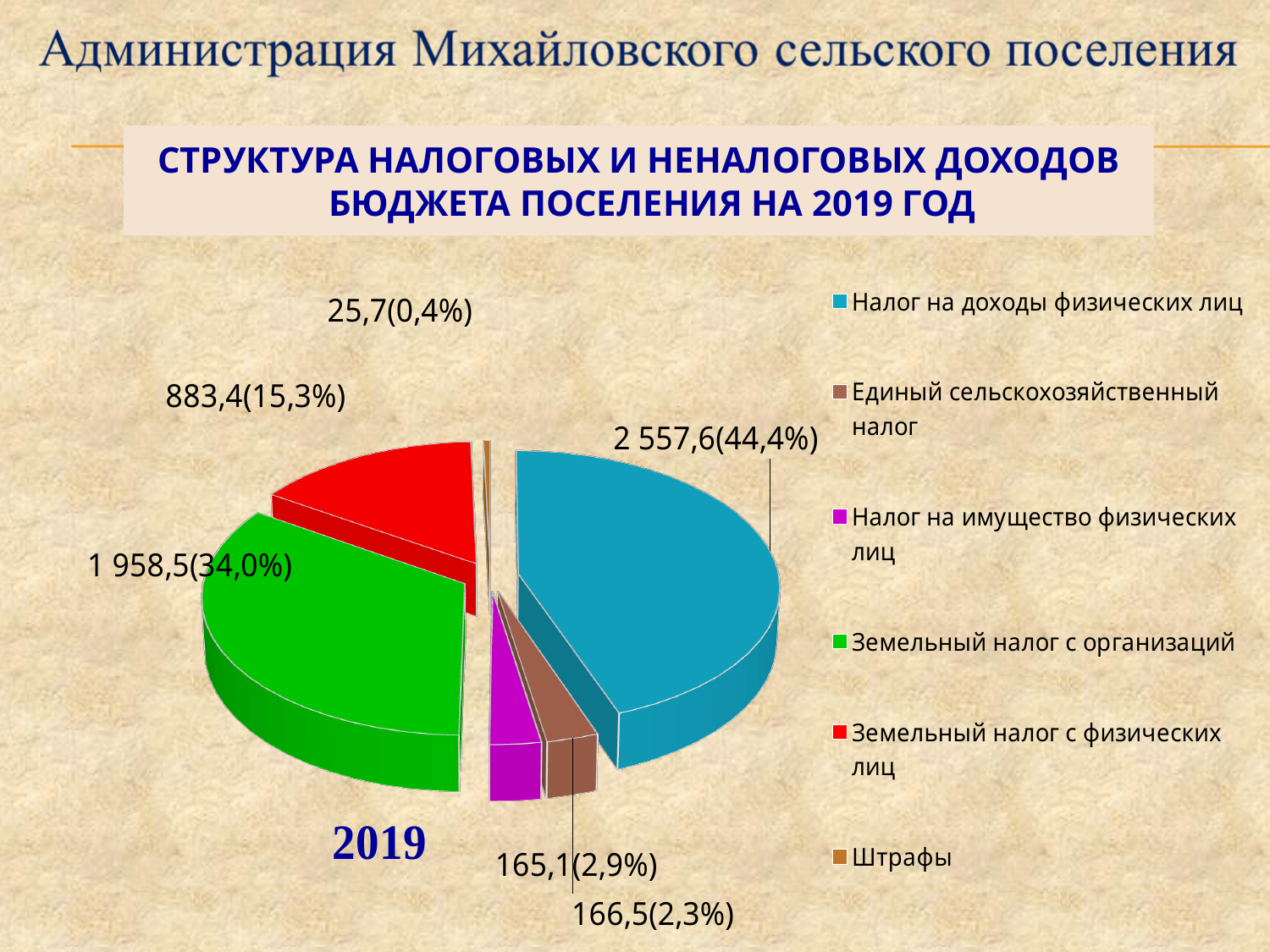
What value is shown for Налог на доходы физических лиц? 2 557,6(44,4%) What share of the pie does Земельный налог с организаций represent? 34,0% What value is shown for Земельный налог с организаций? 1 958,5(34,0%) Which category has the smallest slice of the pie? Штрафы What is the difference between the values for Налог на доходы физических лиц and Земельный налог с организаций? 599,1 How many entries does the legend list? 6 What value is shown for Штрафы? 25,7(0,4%) What kind of chart is shown on the slide? pie chart Which category has the largest slice of the pie? Налог на доходы физических лиц How many slices does the pie chart have? 6 What value is shown for Земельный налог с физических лиц? 883,4(15,3%) Which is larger: Земельный налог с организаций or Земельный налог с физических лиц? Земельный налог с организаций